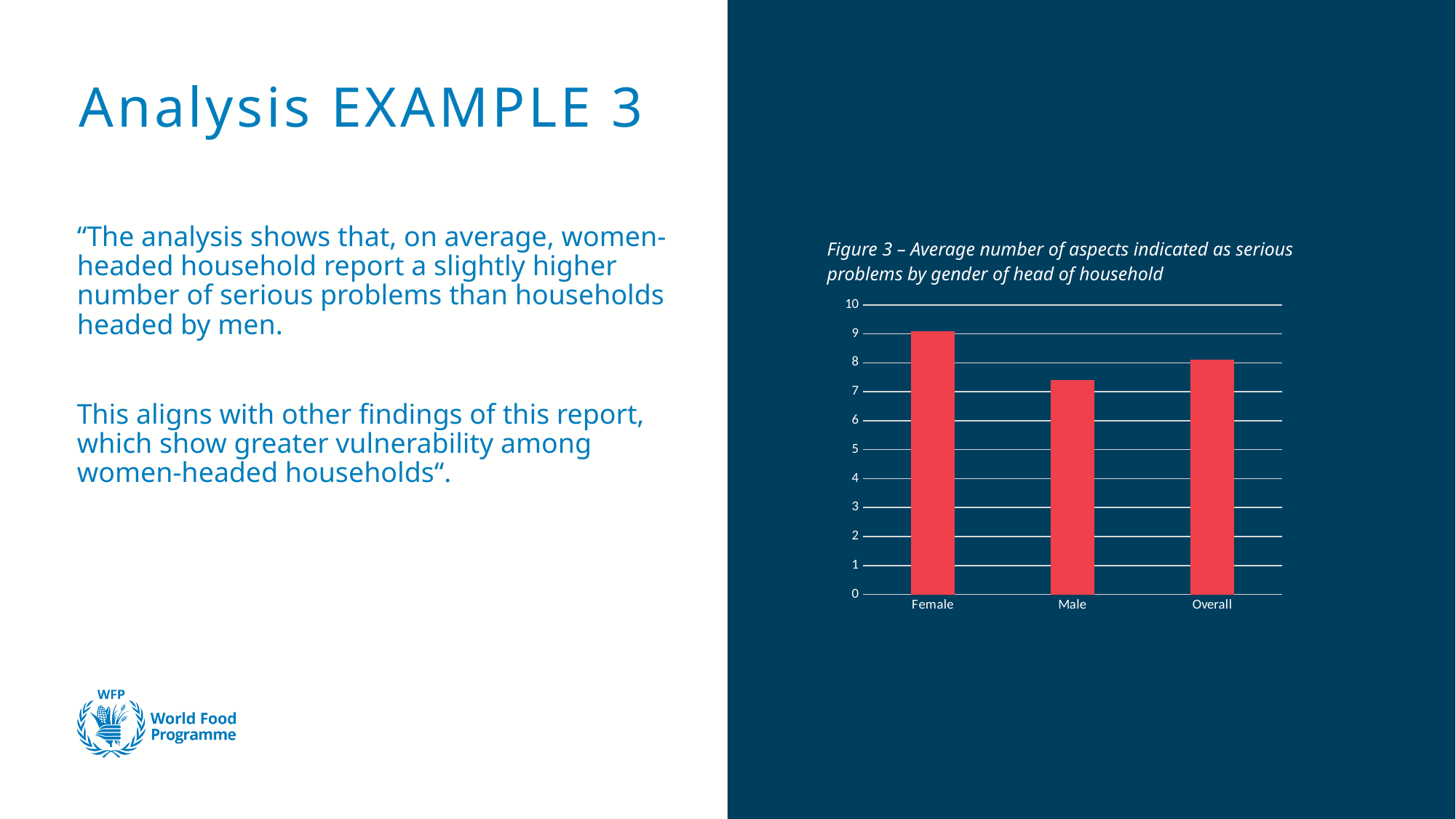
Do the values rise or fall from Female to Male? fall Which category has the lowest bar in the chart? Male Which is larger, the value for Female or the value for Male? Female How many categories are shown on the x axis of the chart? 3 Is the value for Female greater or less than 8? greater Which category has the highest bar in the chart? Female What kind of chart is shown on the slide? bar chart Is the value for Male greater or less than 7? greater Which is larger, the value for Overall or the value for Male? Overall Is the value for Male greater or less than 8? less What is the title of the chart? Figure 3 – Average number of aspects indicated as serious problems by gender of head of household